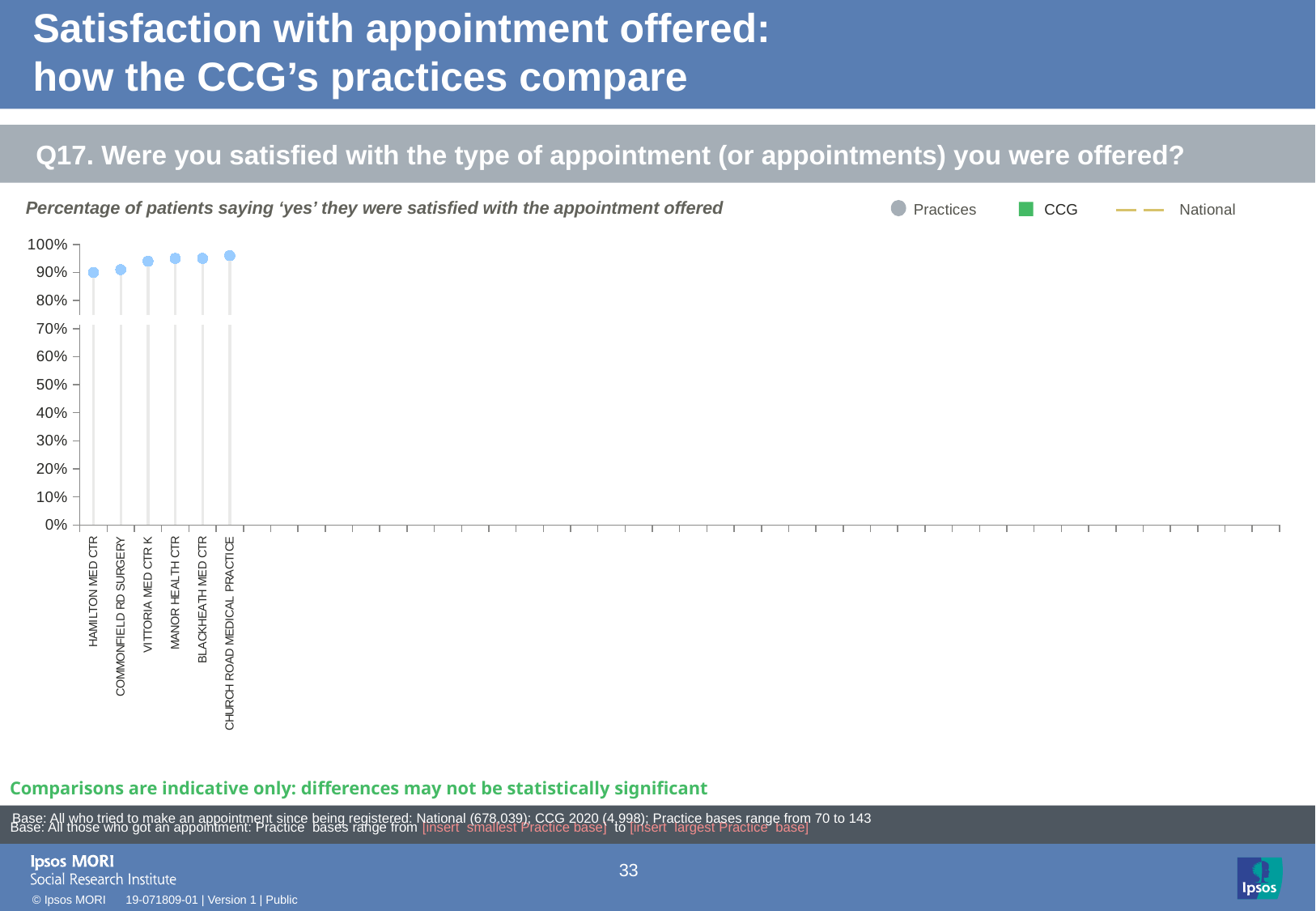
How many series does the chart legend list? 3 Is the value for HAMILTON MED CTR greater or less than 80%? greater Is the value for VITTORIA MED CTR K greater or less than 70%? greater What is the highest value shown on the y axis? 100% Do the practice values rise or fall moving from left to right along the x axis? rise What colour is used for the CCG entry in the legend? green Which practice has the highest percentage of patients satisfied with the appointment offered? CHURCH ROAD MEDICAL PRACTICE How many practices are plotted on the chart? 6 Which is larger, the value for CHURCH ROAD MEDICAL PRACTICE or the value for COMMONFIELD RD SURGERY? CHURCH ROAD MEDICAL PRACTICE Is the value for CHURCH ROAD MEDICAL PRACTICE greater or less than 90%? greater Which is larger, the value for VITTORIA MED CTR K or the value for HAMILTON MED CTR? VITTORIA MED CTR K